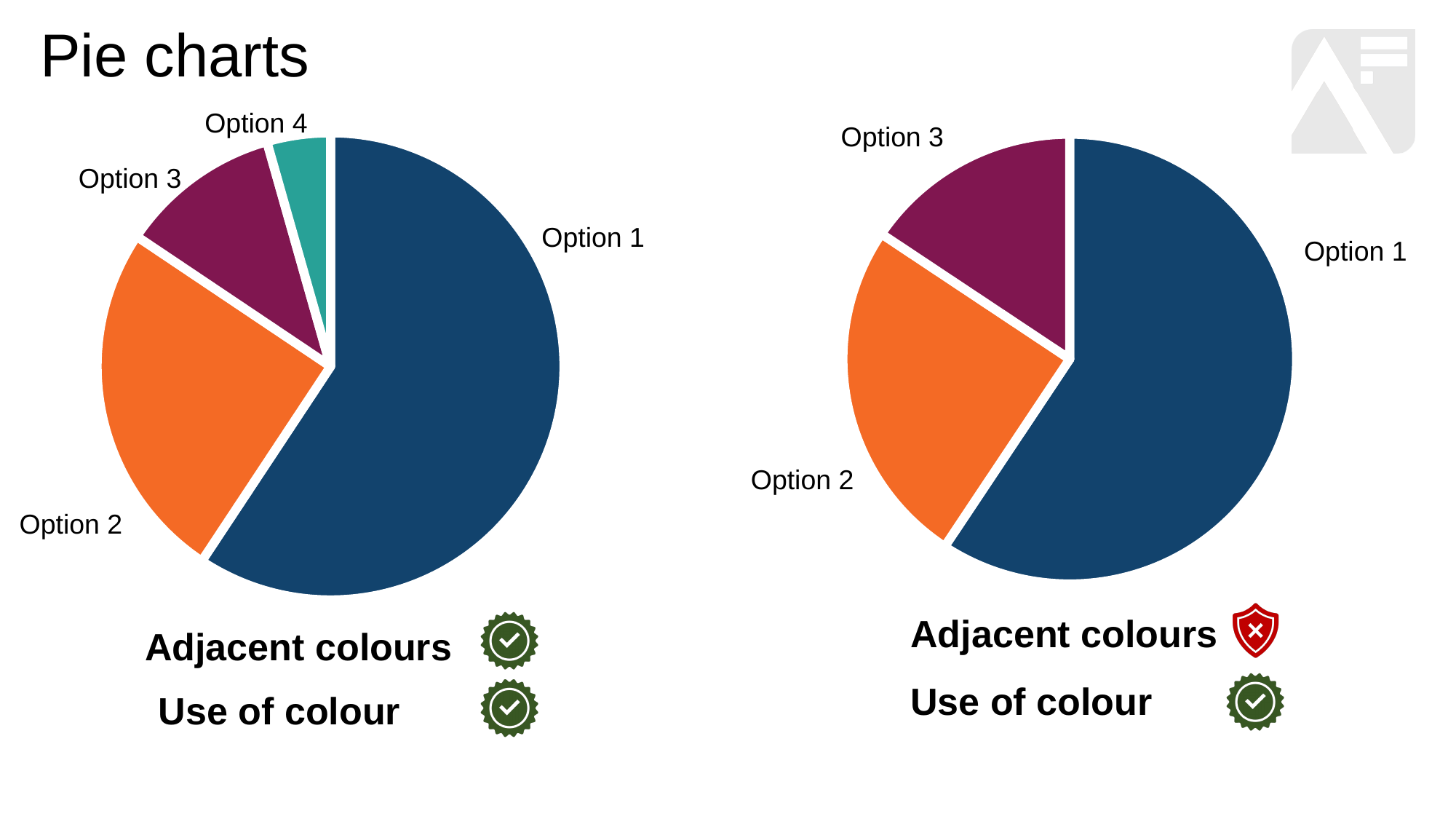
In the left pie chart, which slice is larger, Option 2 or Option 3? Option 2 In the right pie chart, which option has the largest slice? Option 1 In the left pie chart, which option has the largest slice? Option 1 What kind of chart is the right chart on the slide? Pie chart In the left pie chart, what colour is the Option 4 slice? Teal In the right pie chart, which slice is larger, Option 1 or Option 2? Option 1 In the left pie chart, which option has the smallest slice? Option 4 How many slices does the right pie chart have? 3 What kind of chart is the left chart on the slide? Pie chart What is the title of the slide? Pie charts How many slices does the left pie chart have? 4 In the right pie chart, which option has the smallest slice? Option 3